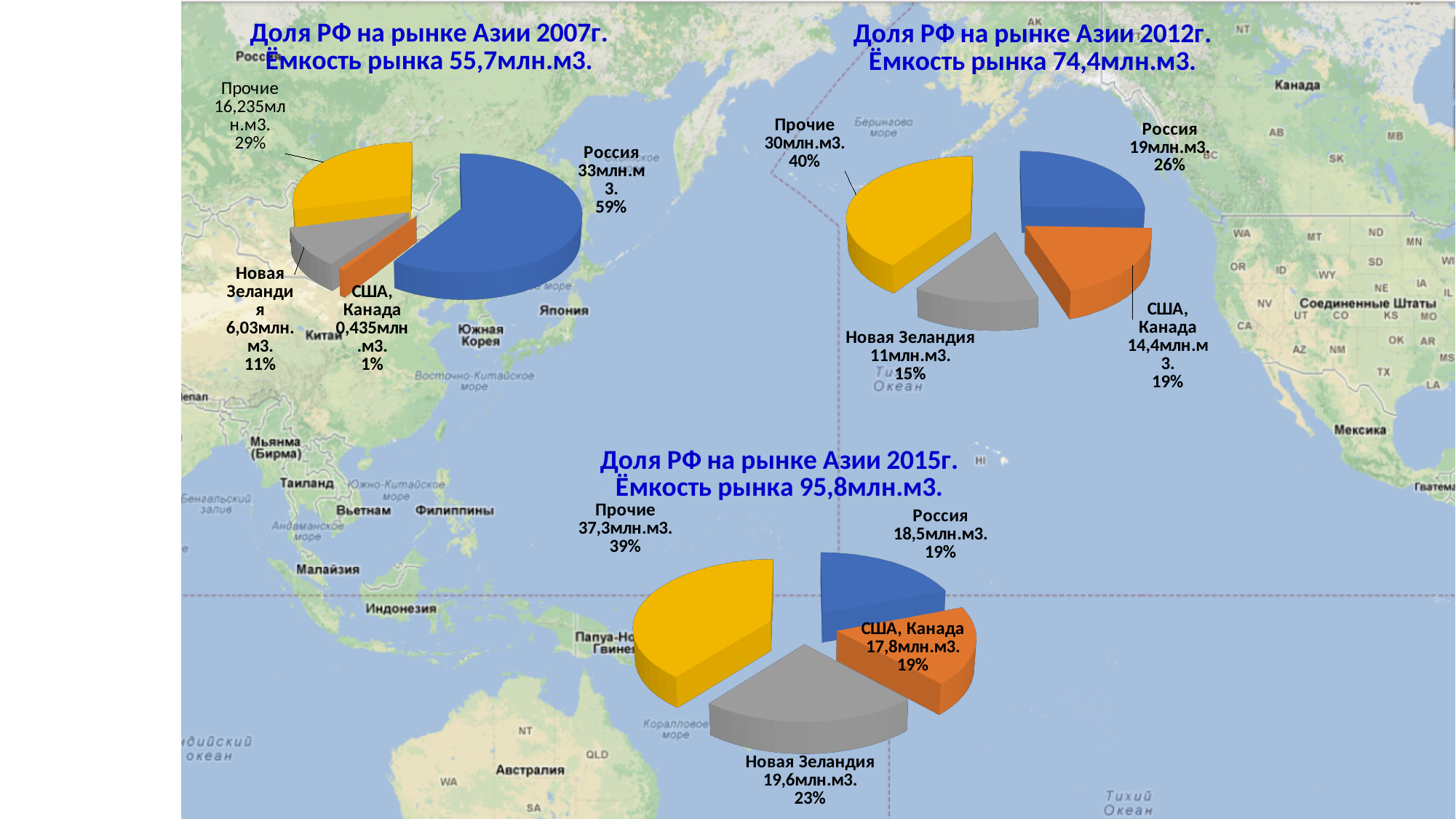
In the chart titled 'Доля РФ на рынке Азии 2012г.', which category has the largest slice? Прочие In the chart titled 'Доля РФ на рынке Азии 2015г.', which is larger: Прочие or Россия? Прочие In the chart titled 'Доля РФ на рынке Азии 2012г.', what share of the pie does Россия hold? 26% In the chart titled 'Доля РФ на рынке Азии 2007г.', what is the value for Россия? 33млн.м3. In the chart titled 'Доля РФ на рынке Азии 2015г.', what share of the pie does Новая Зеландия hold? 23% In the chart titled 'Доля РФ на рынке Азии 2015г.', what is the difference between the values for Новая Зеландия and Россия? 1,1млн.м3. In the chart titled 'Доля РФ на рынке Азии 2007г.', which category has the smallest slice? США, Канада In the chart titled 'Доля РФ на рынке Азии 2012г.', what is the value for Новая Зеландия? 11млн.м3. What kind of chart is the chart titled 'Доля РФ на рынке Азии 2012г.'? Pie chart In the chart titled 'Доля РФ на рынке Азии 2015г.', what is the value for США, Канада? 17,8млн.м3. How many categories does the chart titled 'Доля РФ на рынке Азии 2007г.' show? 4 In the chart titled 'Доля РФ на рынке Азии 2007г.', what share of the pie does Прочие hold? 29%